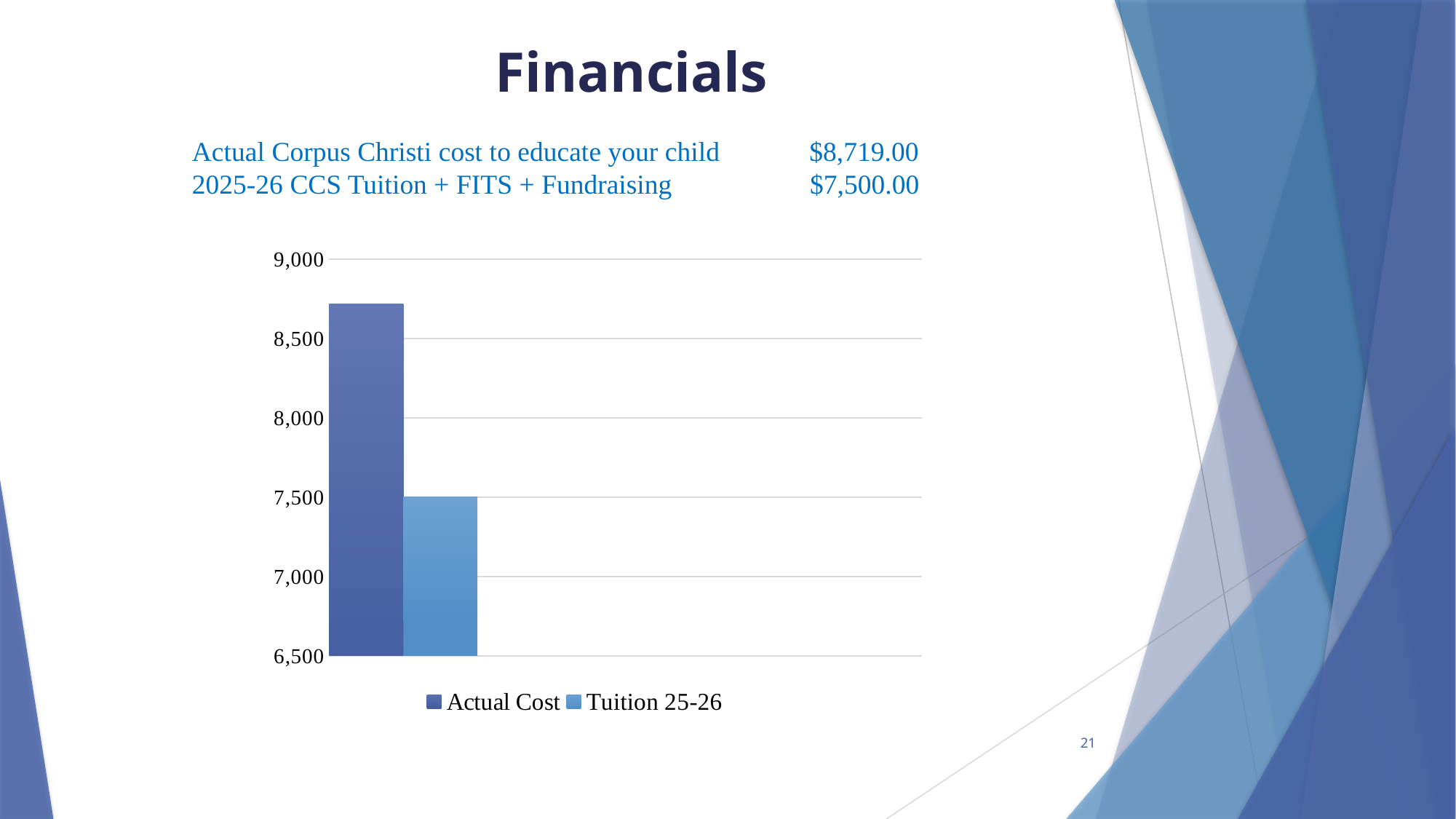
What kind of chart is shown on the slide? bar chart How many bars are plotted in the chart? 2 Using the figures printed on the slide, what is the difference between the Actual Cost and the 2025-26 Tuition + FITS + Fundraising amount? $1,219.00 Is the value for Actual Cost greater or less than 8,500? greater According to the slide, what is the actual Corpus Christi cost to educate a child, shown by the Actual Cost bar? $8,719.00 Which series has the highest bar in the chart? Actual Cost Which series has the higher bar, Actual Cost or Tuition 25-26? Actual Cost What is the lowest value shown on the chart's vertical axis? 6,500 How many series does the chart legend list? 2 Which series has the lowest bar in the chart? Tuition 25-26 What value does the Tuition 25-26 bar reach on the axis? 7,500 Is the value for Tuition 25-26 greater or less than 8,000? less